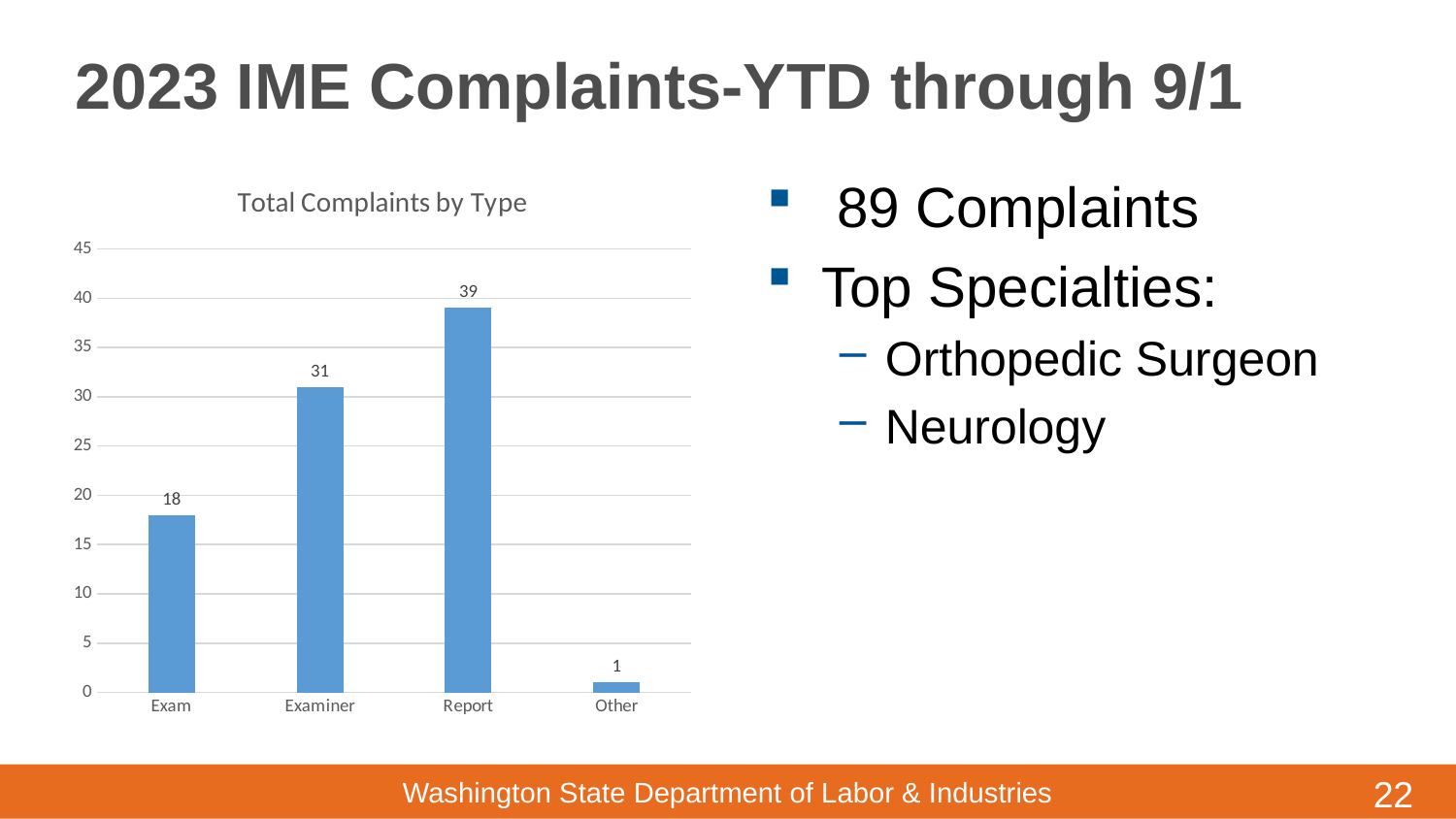
How many categories are shown in the Total Complaints by Type chart? 4 What is the difference between the values for Report and Examiner? 8 What is the value for Examiner in the Total Complaints by Type chart? 31 What is the value for Report in the Total Complaints by Type chart? 39 Which is larger, the value for Exam or the value for Examiner? Examiner What is the value for Exam in the Total Complaints by Type chart? 18 Is the value for Report greater or less than 35? greater What is the value for Other in the Total Complaints by Type chart? 1 What kind of chart is shown on the slide? Bar chart What is the difference between the values for Examiner and Exam? 13 Which category has the lowest value in the Total Complaints by Type chart? Other Which category has the highest value in the Total Complaints by Type chart? Report